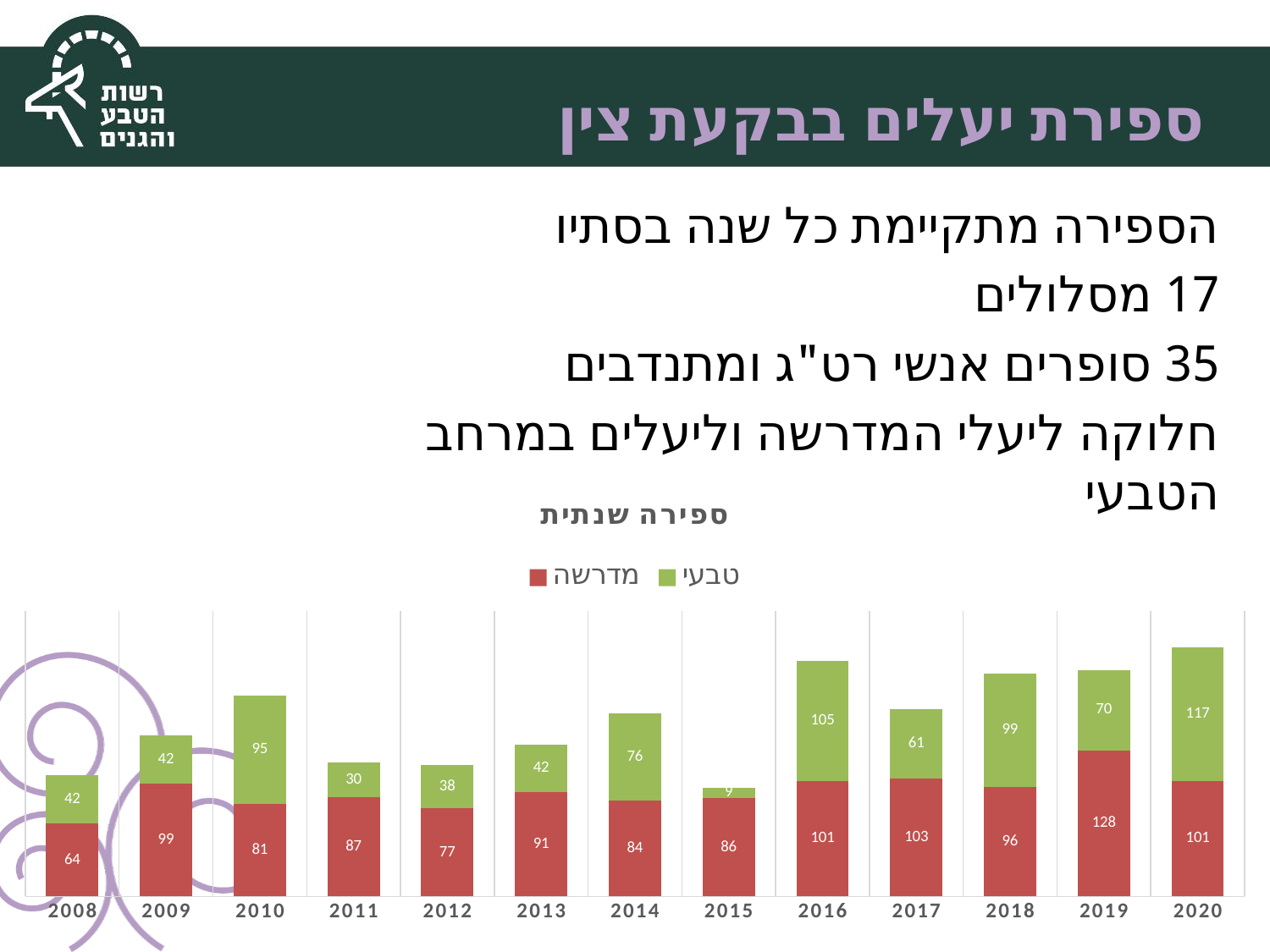
What is the value of the מדרשה series for 2019? 128 Which year has the lowest total stacked bar? 2015 Which is larger, the מדרשה value for 2009 or the מדרשה value for 2010? 2009 What type of chart is shown on the slide? Stacked bar chart How many series does the chart legend list? 2 What is the value of the טבעי series for 2016? 105 Which year has the highest value for the מדרשה series? 2019 What is the title of the chart? ספירה שנתית Which year has the lowest value for the טבעי series? 2015 What is the total of the stacked bar for 2020? 218 How many years are shown on the x axis of the chart? 13 What is the difference between the טבעי values for 2020 and 2019? 47